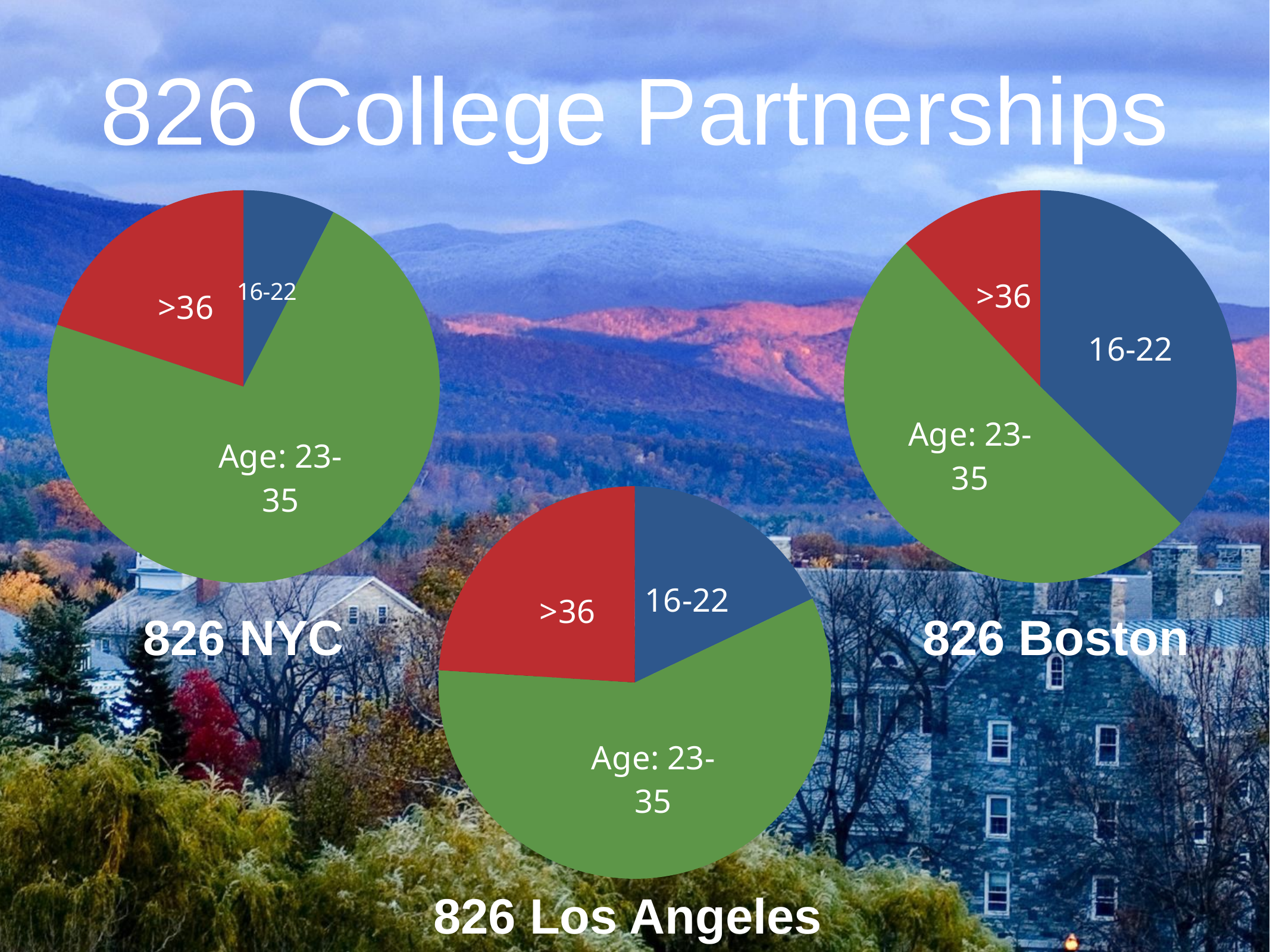
How many slices does the 826 Boston pie chart have? 3 In the 826 Los Angeles pie chart, which age group has the largest slice? Age: 23-35 In the 826 NYC pie chart, which slice is larger: >36 or 16-22? >36 In the 826 Boston pie chart, which age group has the largest slice? Age: 23-35 How many pie charts are shown on the slide? 3 In the 826 Boston pie chart, which age group has the smallest slice? >36 In the 826 Los Angeles pie chart, what colour is the Age: 23-35 slice? green In the 826 NYC pie chart, which age group has the smallest slice? 16-22 What kind of chart is used for 826 NYC? pie chart In the 826 Boston pie chart, which slice is larger: 16-22 or >36? 16-22 In the 826 NYC pie chart, which age group has the largest slice? Age: 23-35 In the 826 Los Angeles pie chart, which age group has the smallest slice? 16-22